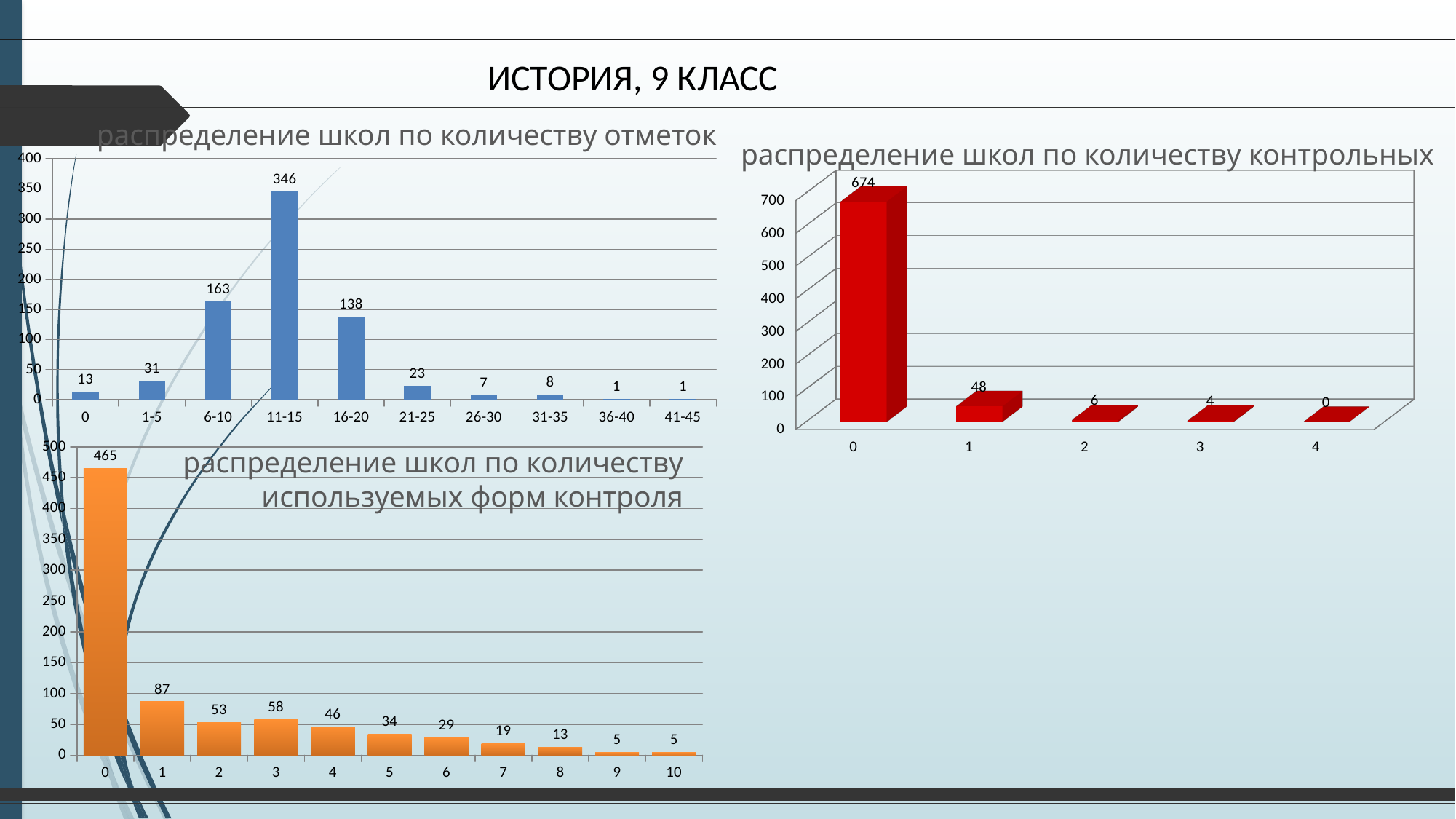
In the chart 'распределение школ по количеству контрольных', do the values rise or fall as you move from category 0 to category 4? fall In the chart 'распределение школ по количеству используемых форм контроля', which is larger, the value for category 2 or category 3? category 3 In the chart 'распределение школ по количеству контрольных', which category has the lowest value? 4 What type of chart is 'распределение школ по количеству контрольных'? bar chart How many categories are shown in the chart 'распределение школ по количеству отметок'? 10 In the chart 'распределение школ по количеству отметок', which category has the highest value? 11-15 What colour are the bars in the chart 'распределение школ по количеству используемых форм контроля'? orange How many categories are shown in the chart 'распределение школ по количеству используемых форм контроля'? 11 In the chart 'распределение школ по количеству контрольных', what is the value for category 0? 674 In the chart 'распределение школ по количеству отметок', what is the value for the category 11-15? 346 In the chart 'распределение школ по количеству отметок', what is the difference between the values for 6-10 and 16-20? 25 In the chart 'распределение школ по количеству используемых форм контроля', what is the value for category 1? 87